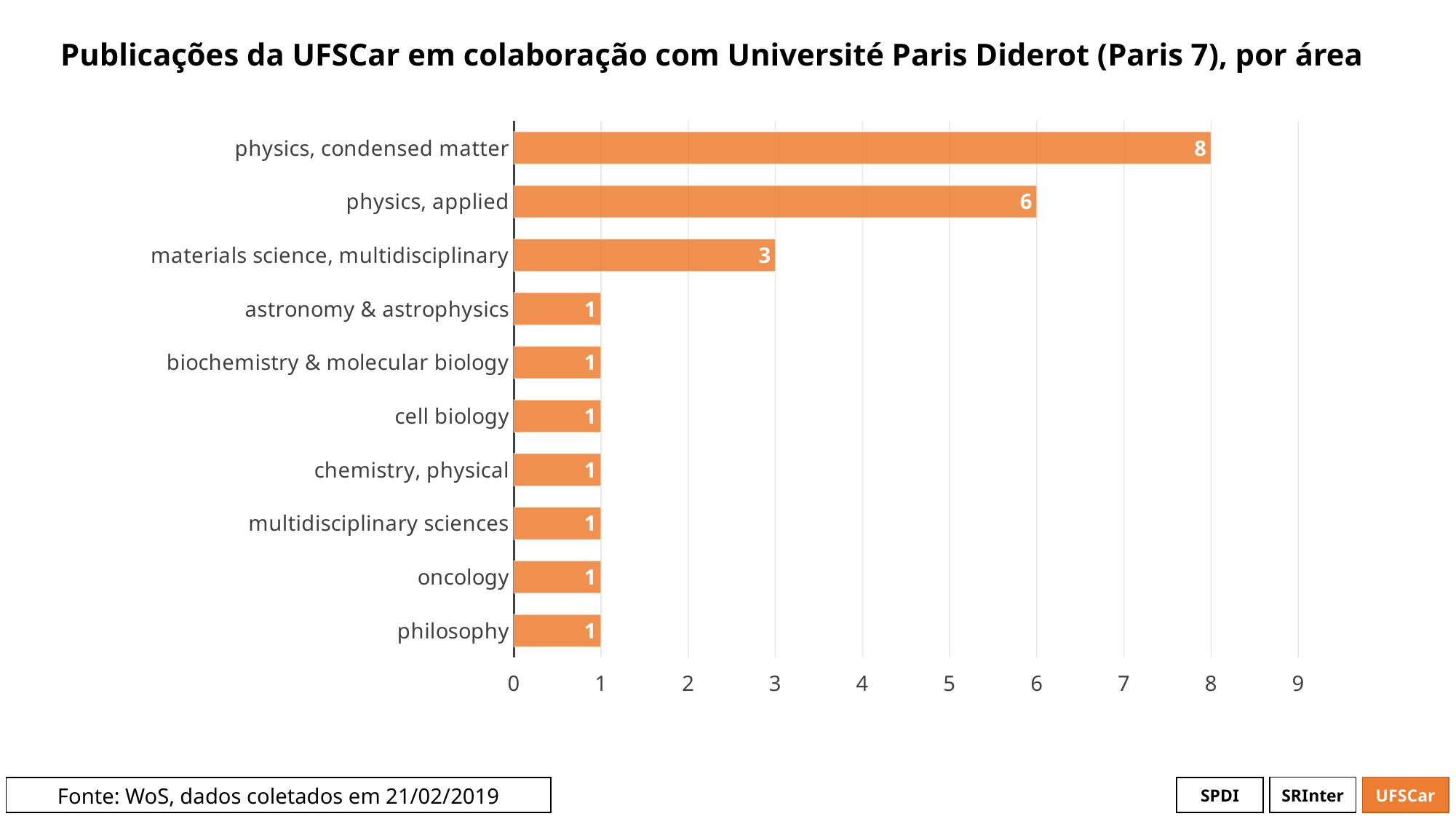
What is the value for materials science, multidisciplinary? 3 Is the value for physics, applied greater or less than 5? greater How many areas are shown in the chart? 10 What is the difference between the values for physics, applied and materials science, multidisciplinary? 3 What is the value for oncology? 1 Which is larger, the value for materials science, multidisciplinary or the value for cell biology? materials science, multidisciplinary Which area has the highest number of publications? physics, condensed matter What is the value for physics, applied? 6 What is the value for physics, condensed matter? 8 What is the title of the chart? Publicações da UFSCar em colaboração com Université Paris Diderot (Paris 7), por área What kind of chart is shown on the slide? bar chart What is the difference between the values for physics, condensed matter and physics, applied? 2